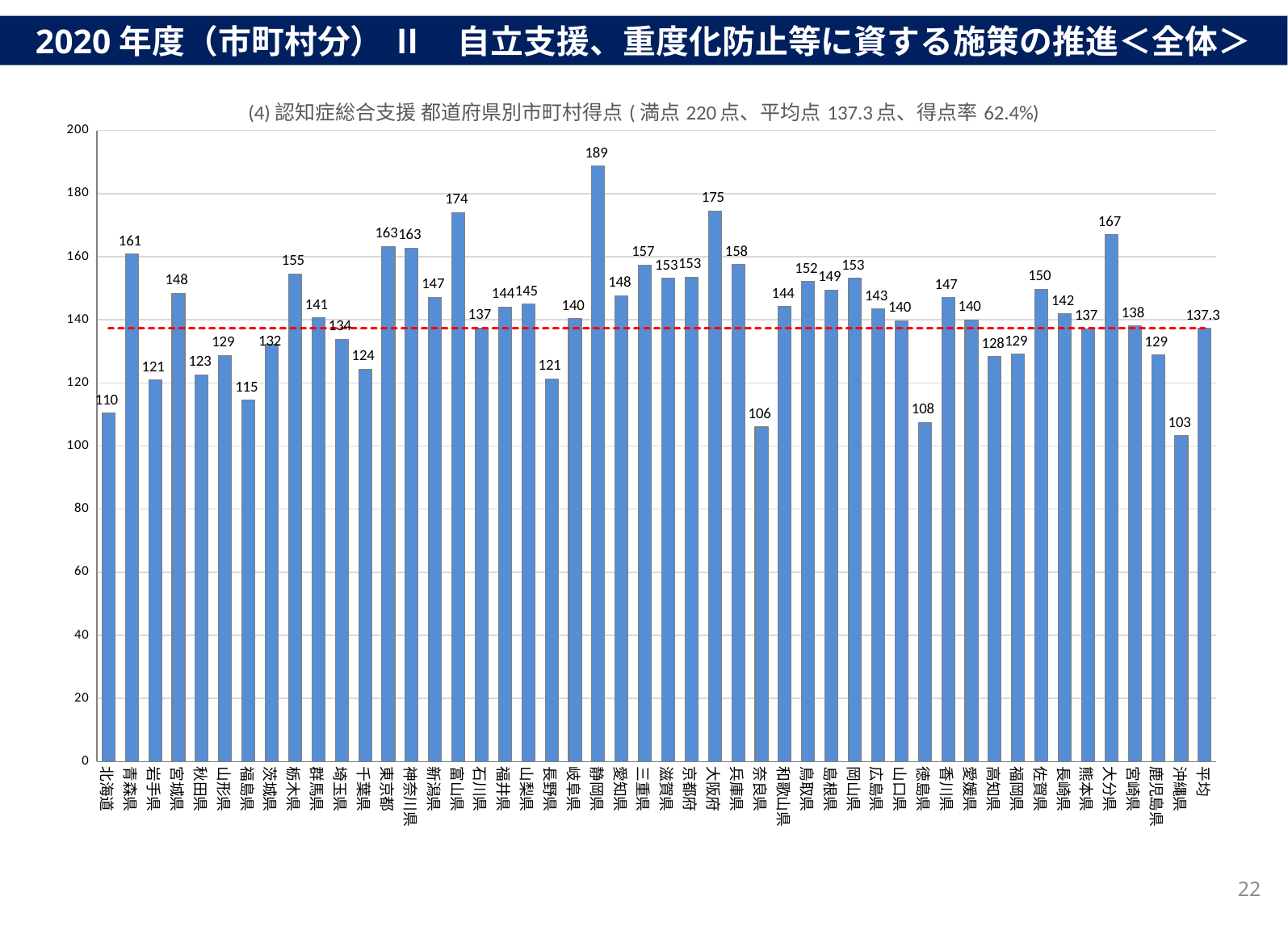
What is the value for 沖縄県? 103 What is the 満点 (maximum possible score) stated in the chart title? 220点 What is the value for 東京都? 163 What is the value for 静岡県? 189 What is the value shown for 平均? 137.3 Is the value for 北海道 greater or less than 120? less How many bars are plotted in the chart? 48 What is the difference between the values for 大阪府 and 奈良県? 69 Which is larger, the value for 富山県 or the value for 大分県? 富山県 Which category has the lowest value? 沖縄県 What kind of chart is shown on the slide? bar chart Which category has the highest value? 静岡県